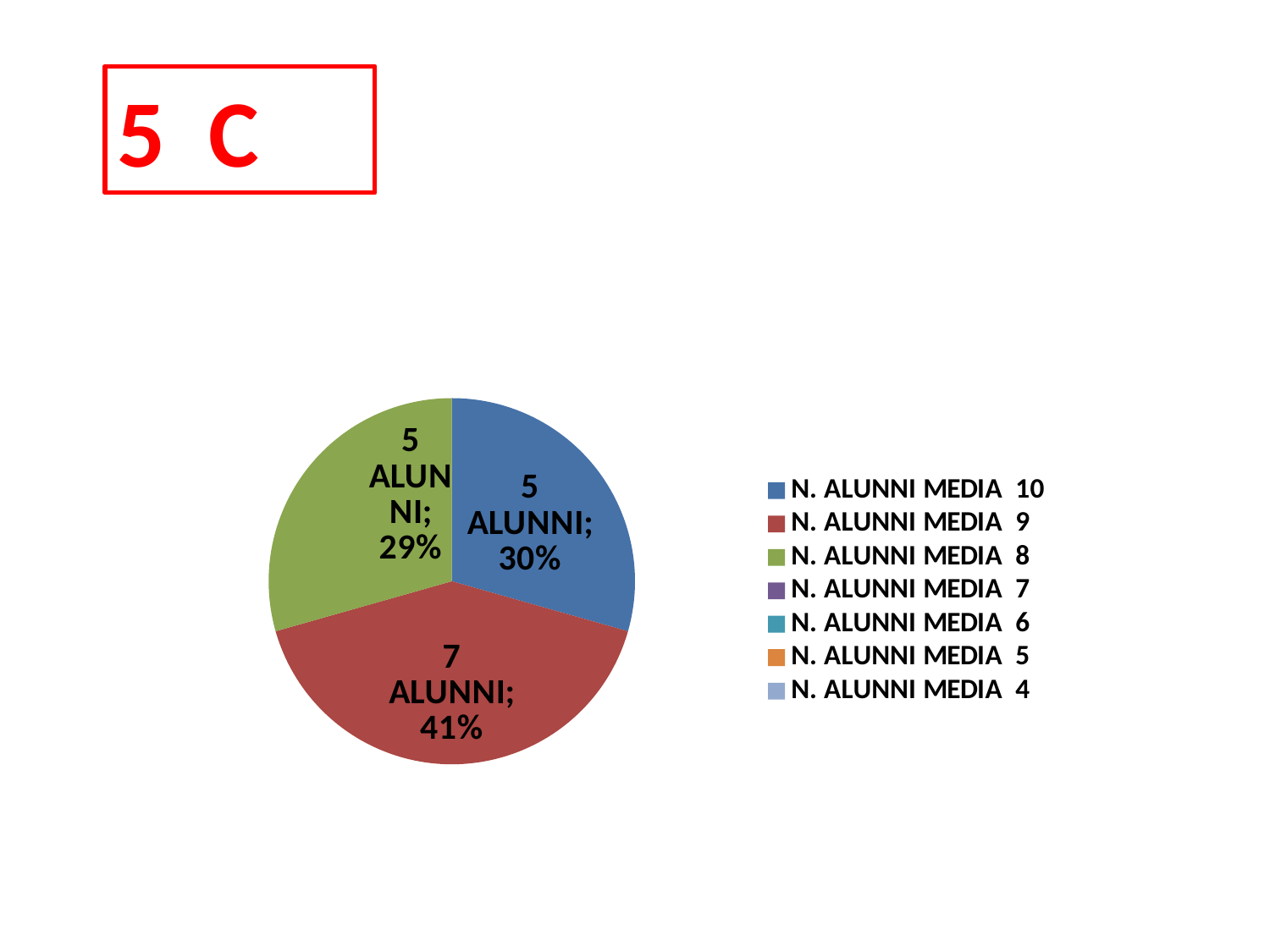
How many entries does the legend list? 7 What percentage share does the N. ALUNNI MEDIA 8 slice have? 29% Which legend category has the largest slice of the pie? N. ALUNNI MEDIA 9 How many slices are visible in the pie chart? 3 What colour is the N. ALUNNI MEDIA 8 slice? green Which is larger, the N. ALUNNI MEDIA 9 slice or the N. ALUNNI MEDIA 10 slice? N. ALUNNI MEDIA 9 How many alunni are in the N. ALUNNI MEDIA 9 slice? 7 ALUNNI What is the difference in percentage points between the N. ALUNNI MEDIA 9 slice and the N. ALUNNI MEDIA 8 slice? 12 How many alunni are in the N. ALUNNI MEDIA 8 slice? 5 ALUNNI What percentage share does the N. ALUNNI MEDIA 10 slice have? 30% What kind of chart is shown on the slide? pie chart What percentage share does the N. ALUNNI MEDIA 9 slice have? 41%